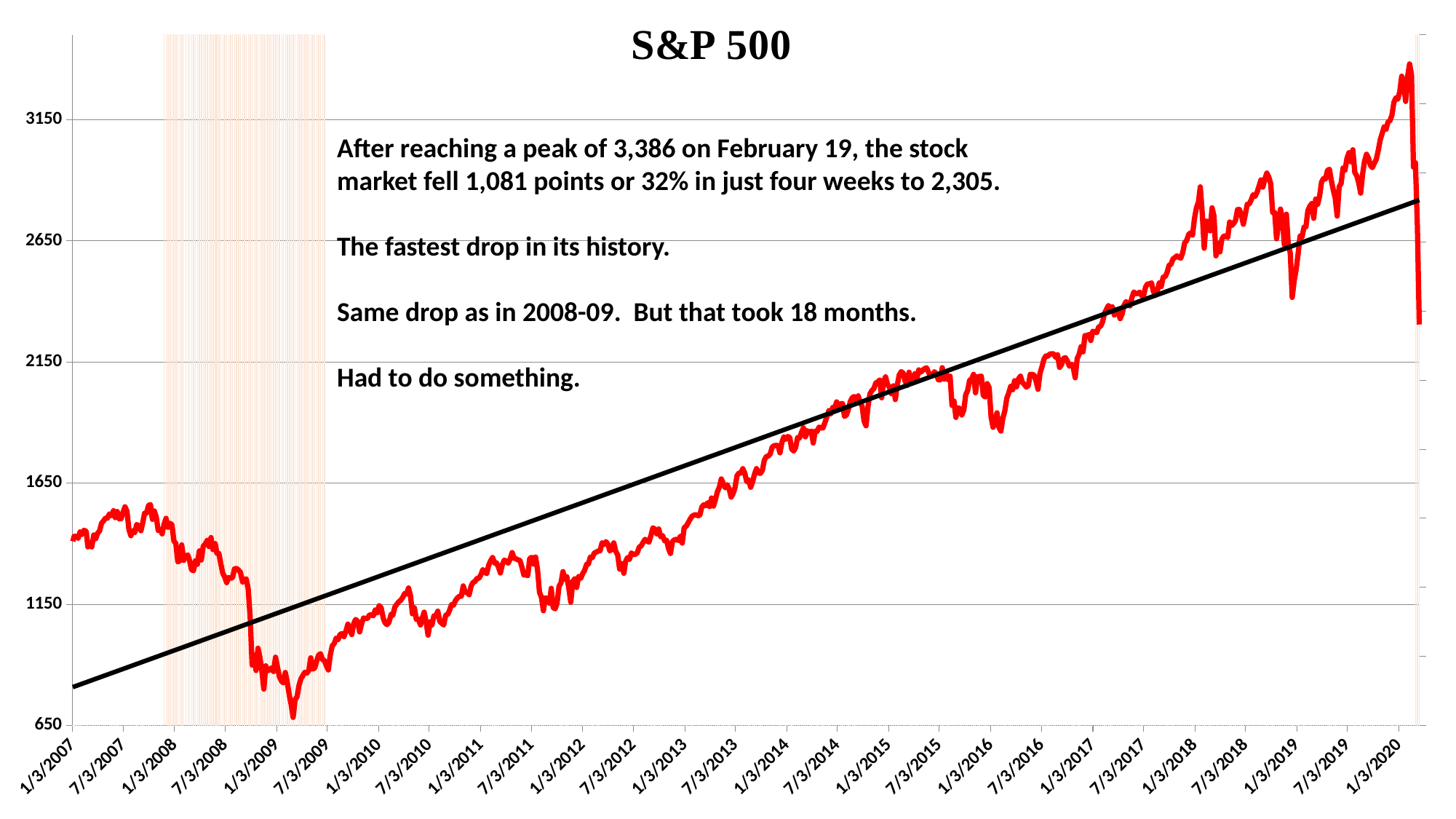
What percentage drop does the slide say the market suffered in four weeks? 32% Is the value of the S&P 500 at 1/3/2007 greater or less than 1150? greater According to the slide, to what level did the stock market fall in four weeks after the February 19 peak? 2,305 Is the value of the S&P 500 at 1/3/2009 greater or less than 1150? less Is the value of the S&P 500 at 1/3/2017 greater or less than 2150? greater In which year does the S&P 500 line reach its lowest point on the chart? 2009 Over the whole period from 2007 to 2020, does the S&P 500 line generally rise or fall? rise By how many points did the market fall from its peak of 3,386 to 2,305? 1,081 What kind of chart is shown on the slide? line chart In which year does the S&P 500 line reach its highest point on the chart? 2020 According to the slide, what peak did the S&P 500 reach on February 19? 3,386 What is the title of the chart? S&P 500